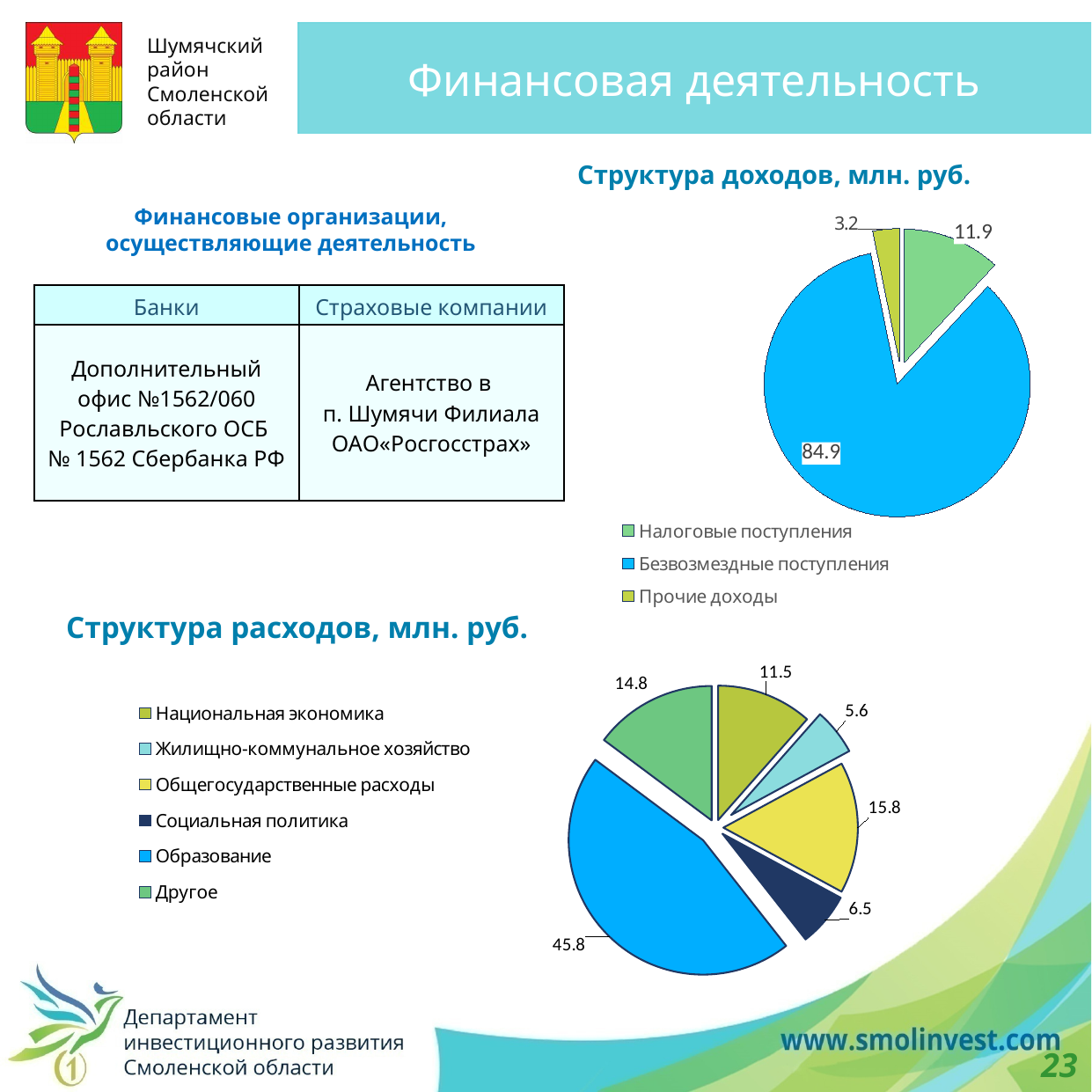
In the 'Структура расходов, млн. руб.' chart, which is larger: Национальная экономика or Социальная политика? Национальная экономика How many slices does the 'Структура расходов, млн. руб.' pie chart have? 6 In the 'Структура расходов, млн. руб.' chart, which category has the largest value? Образование In the 'Структура расходов, млн. руб.' chart, what is the value for Образование? 45.8 In the 'Структура расходов, млн. руб.' chart, what is the value for Общегосударственные расходы? 15.8 In the 'Структура доходов, млн. руб.' chart, what is the value for Налоговые поступления? 11.9 In the 'Структура доходов, млн. руб.' chart, which category has the smallest value? Прочие доходы In the 'Структура доходов, млн. руб.' chart, what is the difference between Безвозмездные поступления and Налоговые поступления? 73.0 In the 'Структура расходов, млн. руб.' chart, which category has the smallest value? Жилищно-коммунальное хозяйство In the 'Структура доходов, млн. руб.' chart, what is the value for Безвозмездные поступления? 84.9 How many categories does the legend of the 'Структура доходов, млн. руб.' chart list? 3 What type of chart is 'Структура расходов, млн. руб.'? Pie chart